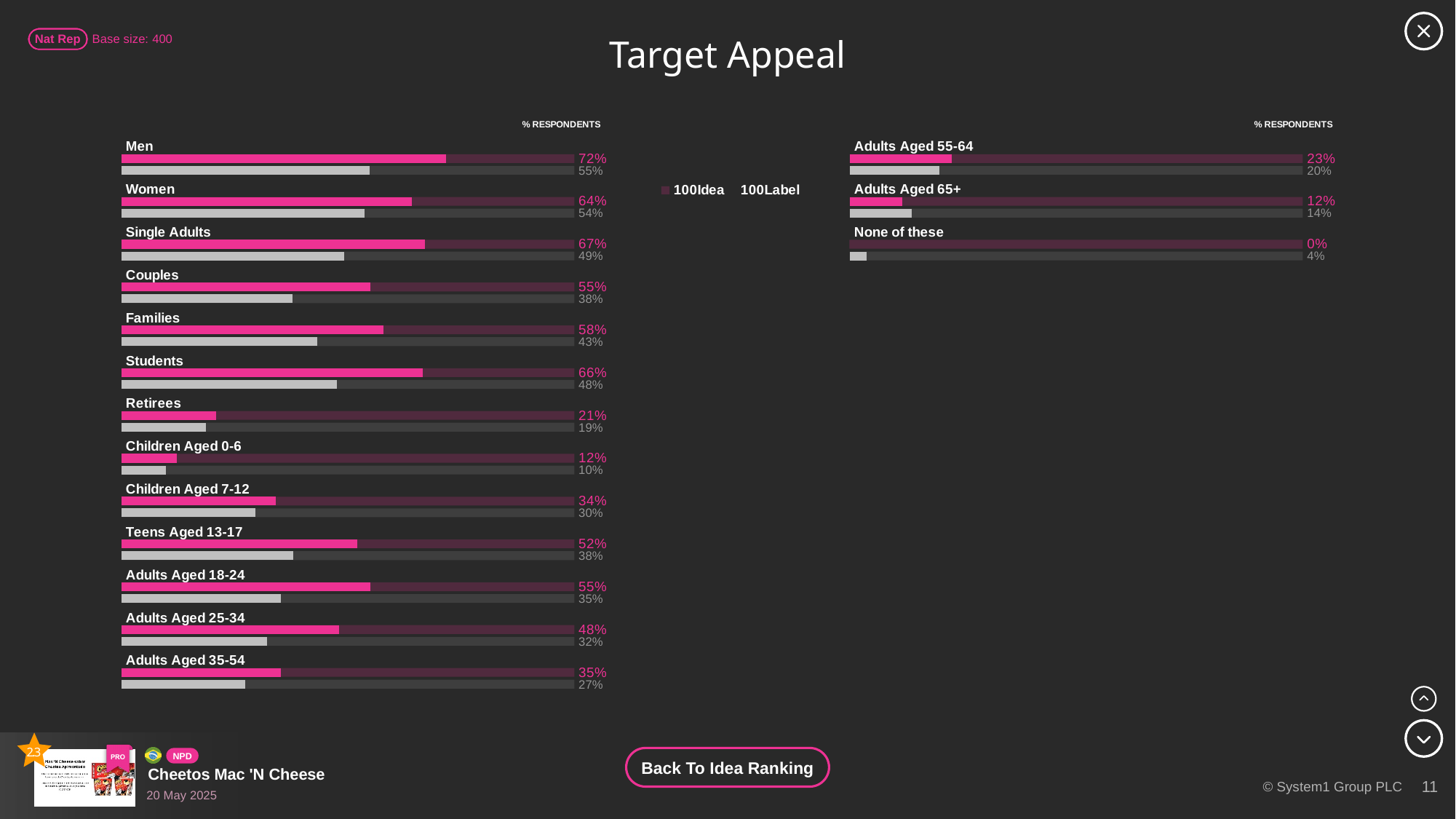
How many categories are shown on the slide? 16 Which category has the lowest pink (Idea) value? None of these What is the grey value for None of these? 4% Which has a higher pink value, Students or Families? Students What kind of chart is shown on the slide? bar chart Which is larger for Adults Aged 65+, the pink value or the grey value? the grey value What is the difference between the pink and grey values for Couples? 17% What is the difference between the pink values for Men and Women? 8% What is the grey value for Single Adults? 49% Which category has the highest pink (Idea) value? Men What is the pink value for Adults Aged 55-64? 23% What is the pink (Idea) value for Men? 72%